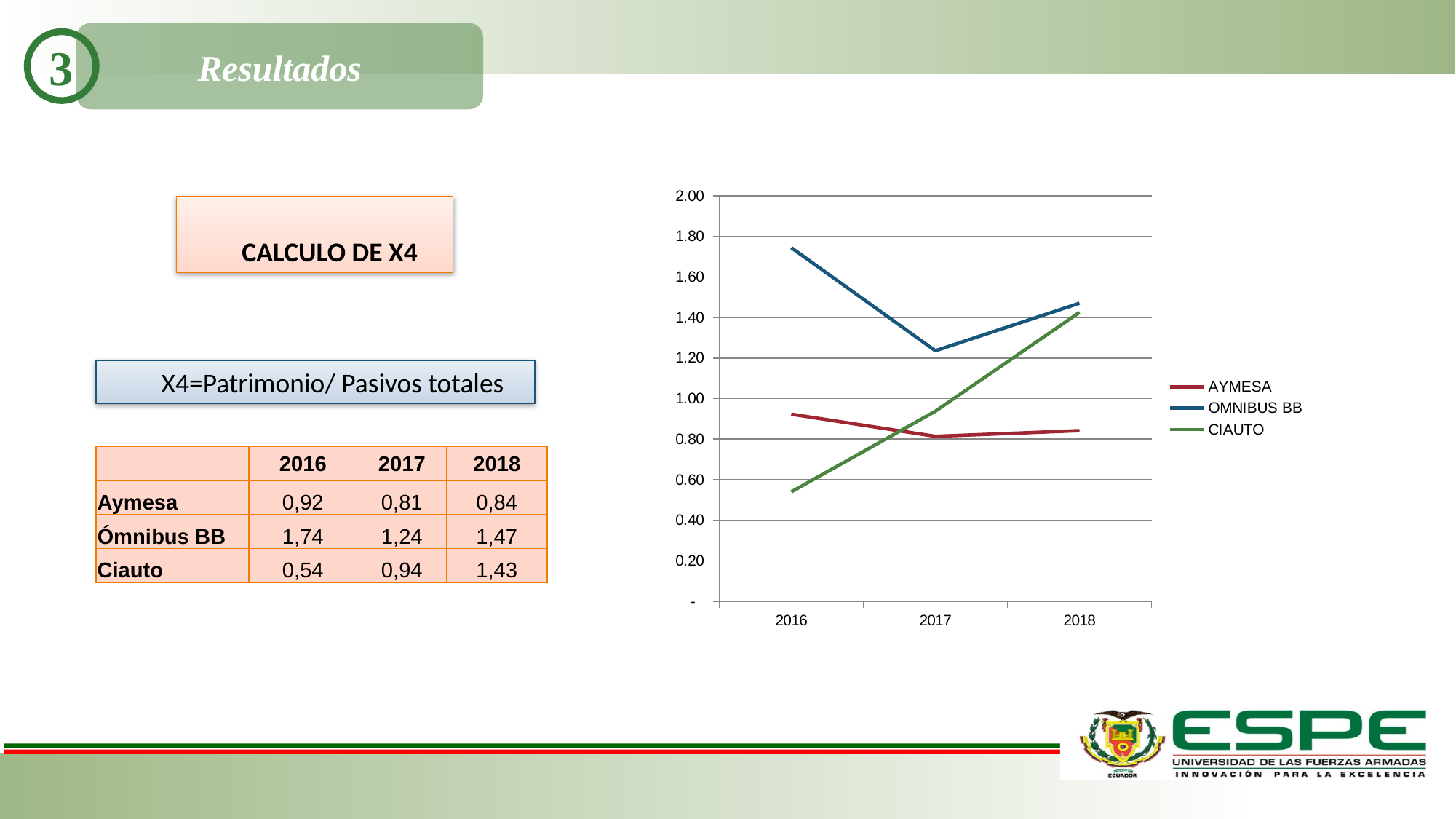
Which series has the lowest value in 2016? CIAUTO What is the value for AYMESA in 2017? 0,81 Which is larger in 2017, the value for CIAUTO or the value for AYMESA? CIAUTO How many series does the chart legend list? 3 Which series has the highest value in 2016? OMNIBUS BB Does the CIAUTO series rise or fall from 2016 to 2018? rise What kind of chart is shown on the slide? line chart What is the value for CIAUTO in 2018? 1,43 What is the difference between the OMNIBUS BB values in 2016 and 2017? 0,50 How many years are plotted along the x axis of the chart? 3 What is the value for OMNIBUS BB in 2016? 1,74 Is the value for OMNIBUS BB in 2018 greater or less than 1.40? greater